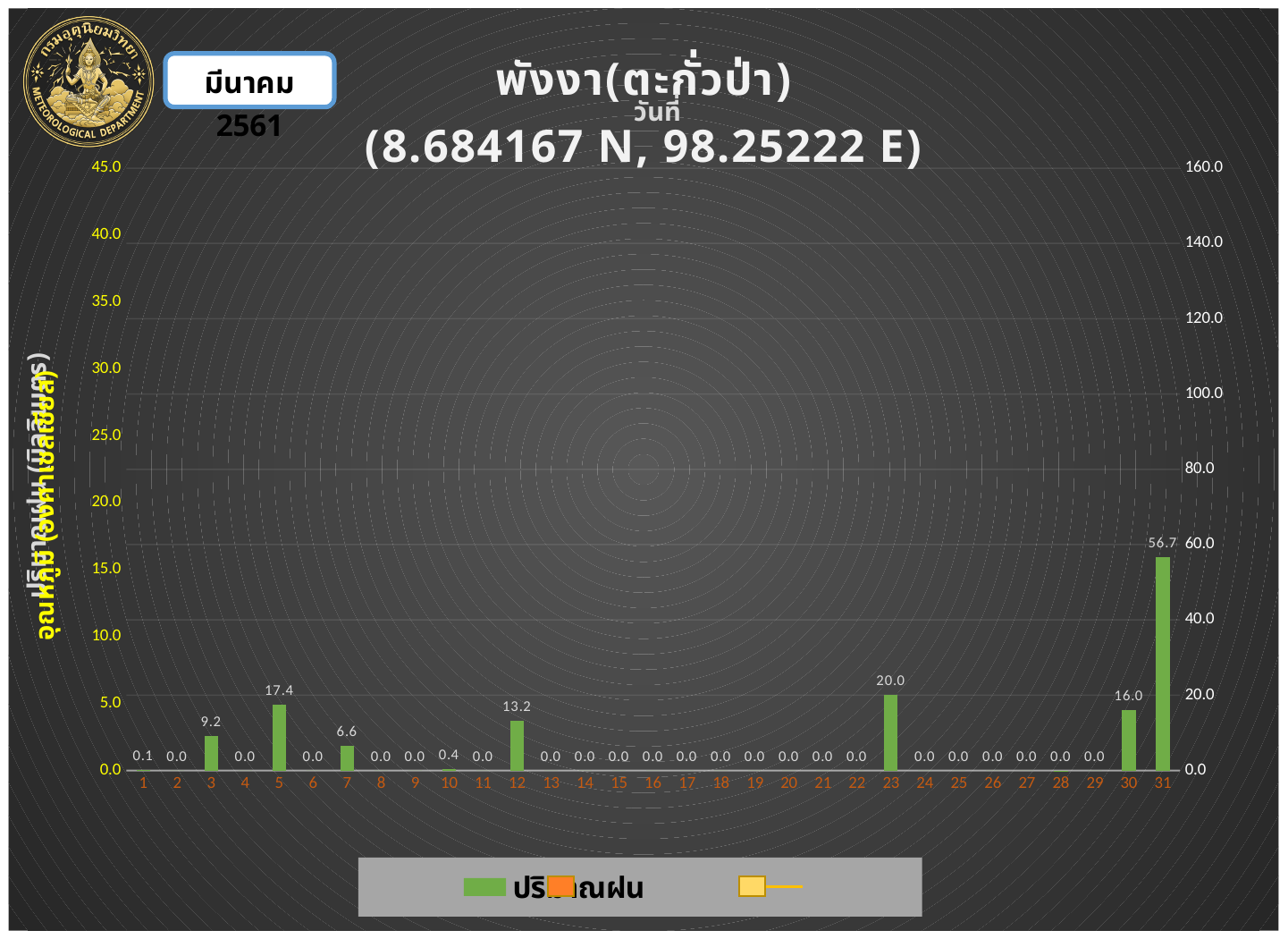
How many days are shown on the x axis? 31 What is the rainfall value for day 10? 0.4 What is the rainfall value for day 7? 6.6 What is the difference between the rainfall values for day 23 and day 5? 2.6 What is the rainfall value for day 5? 17.4 What station name is shown in the chart title? พังงา(ตะกั่วป่า) What is the rainfall value for day 23? 20.0 Which day has the highest rainfall value? 31 What kind of chart is shown on the slide? bar chart What is the difference between the rainfall values for day 31 and day 30? 40.7 What is the rainfall value for day 31? 56.7 Which day has a larger rainfall value, day 12 or day 3? 12